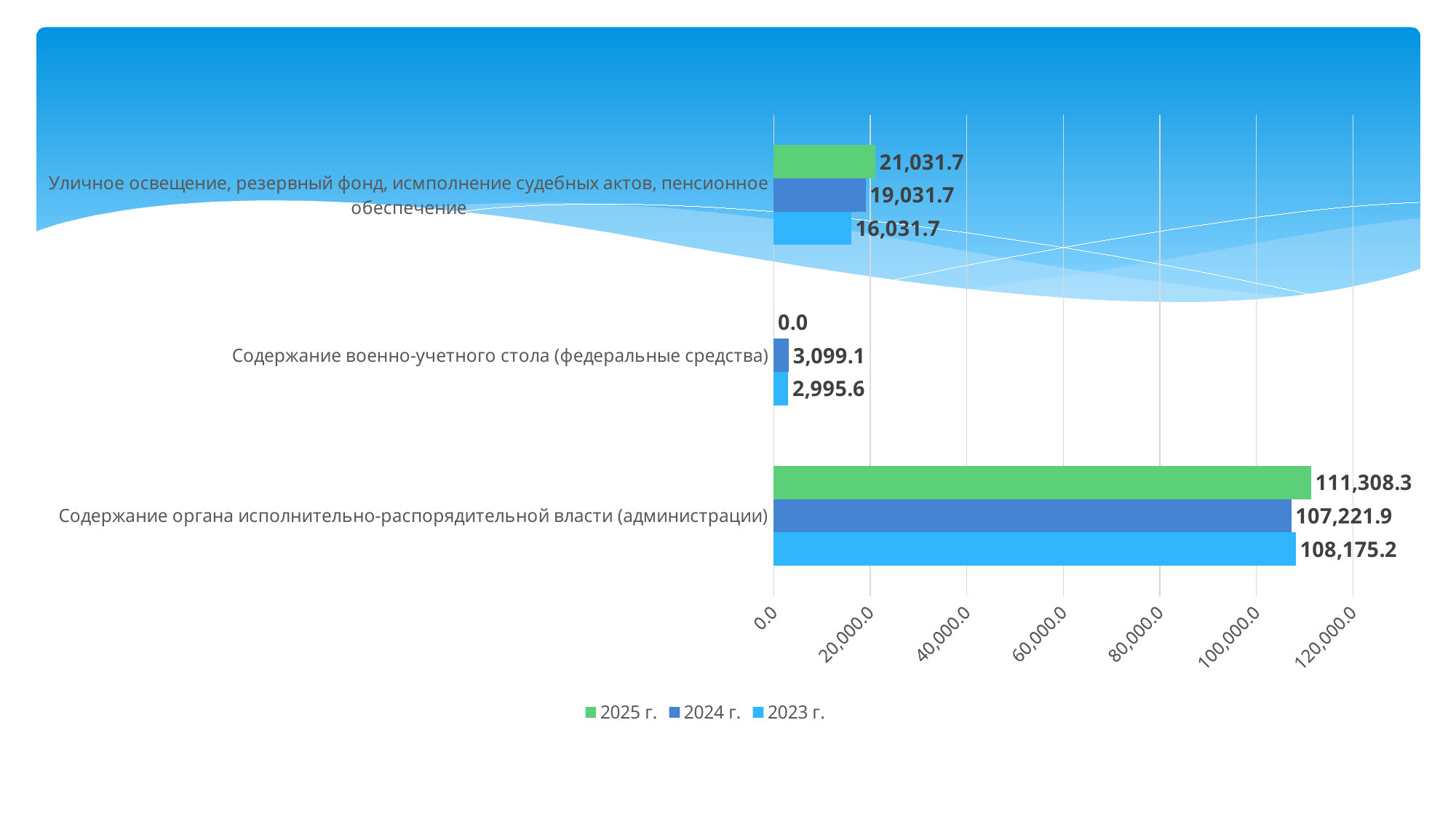
For "Содержание органа исполнительно-распорядительной власти (администрации)", which is larger: the 2024 г. value or the 2023 г. value? 2023 г. What is the value for 2025 г. for "Содержание военно-учетного стола (федеральные средства)"? 0.0 What is the value for 2024 г. for "Уличное освещение, резервный фонд, исмполнение судебных актов, пенсионное обеспечение"? 19,031.7 Is the 2025 г. value for "Содержание органа исполнительно-распорядительной власти (администрации)" greater or less than 100,000.0? greater How many categories are shown on the chart? 3 What is the difference between the 2025 г. and 2023 г. values for "Уличное освещение, резервный фонд, исмполнение судебных актов, пенсионное обеспечение"? 5,000.0 What kind of chart is shown on the slide? Bar chart How many series does the legend list? 3 What is the value for 2025 г. for "Содержание органа исполнительно-распорядительной власти (администрации)"? 111,308.3 Which category has the highest value for 2025 г.? Содержание органа исполнительно-распорядительной власти (администрации) What is the value for 2023 г. for "Содержание военно-учетного стола (федеральные средства)"? 2,995.6 Which category has the lowest value for 2023 г.? Содержание военно-учетного стола (федеральные средства)